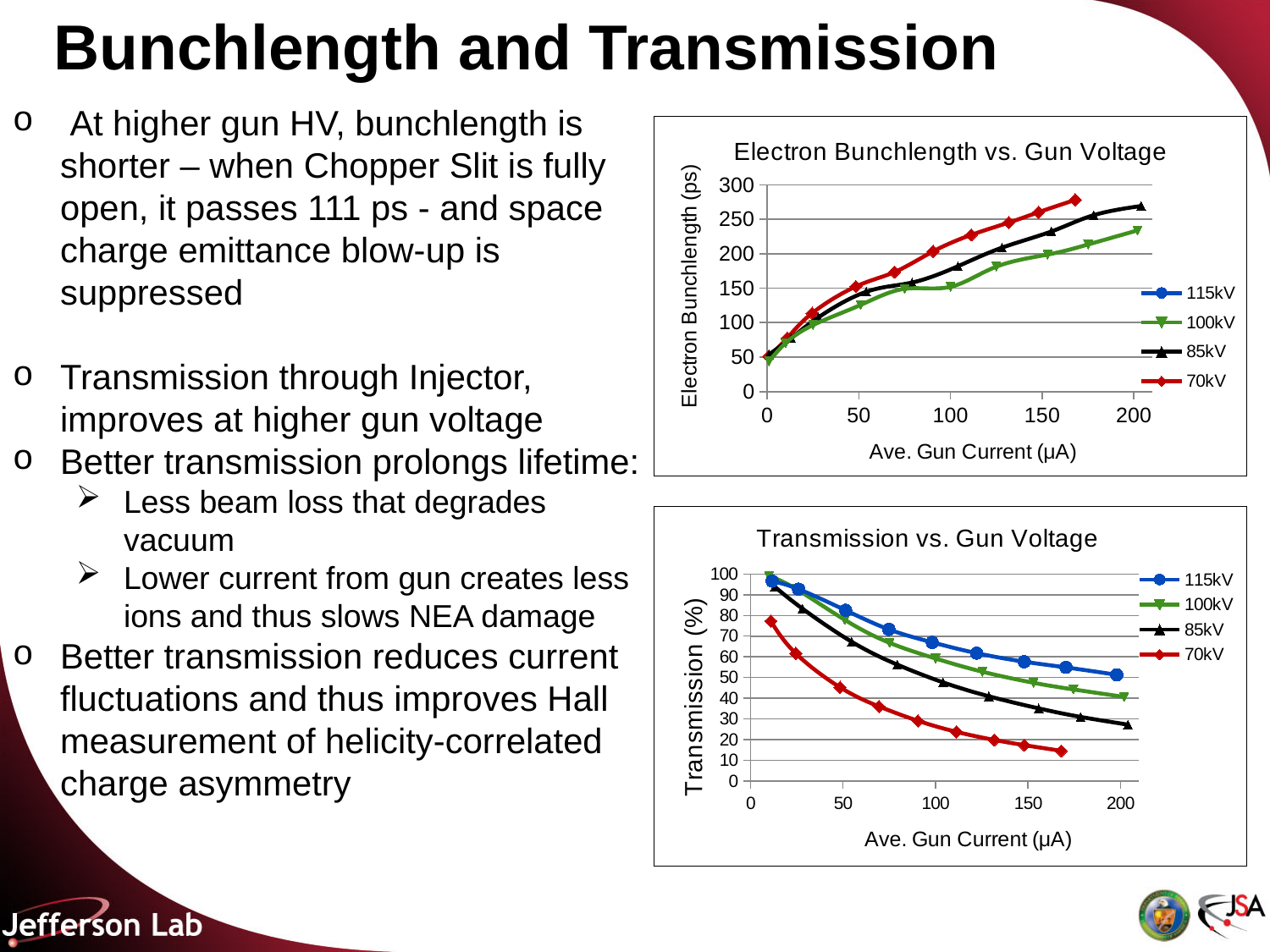
In the 'Electron Bunchlength vs. Gun Voltage' chart, does the electron bunchlength rise or fall as the average gun current increases? rise In the 'Transmission vs. Gun Voltage' chart, does transmission rise or fall as the average gun current increases? fall In the 'Electron Bunchlength vs. Gun Voltage' chart, is the bunchlength for 70kV at 150 µA greater or less than 200? greater In the 'Transmission vs. Gun Voltage' chart, is the transmission for 115kV at 100 µA greater or less than 60? greater In the 'Electron Bunchlength vs. Gun Voltage' chart, at 150 µA, which series has the larger bunchlength, 70kV or 100kV? 70kV What type of chart is the 'Electron Bunchlength vs. Gun Voltage' chart? line chart In the 'Transmission vs. Gun Voltage' chart, which series has the lowest transmission across the plotted current range? 70kV How many series does the legend of the 'Transmission vs. Gun Voltage' chart list? 4 In the 'Transmission vs. Gun Voltage' chart, at 100 µA, which series has the larger transmission, 115kV or 70kV? 115kV In the 'Transmission vs. Gun Voltage' chart, which series has the highest transmission across the plotted current range? 115kV What is the x-axis label of the 'Transmission vs. Gun Voltage' chart? Ave. Gun Current (µA)